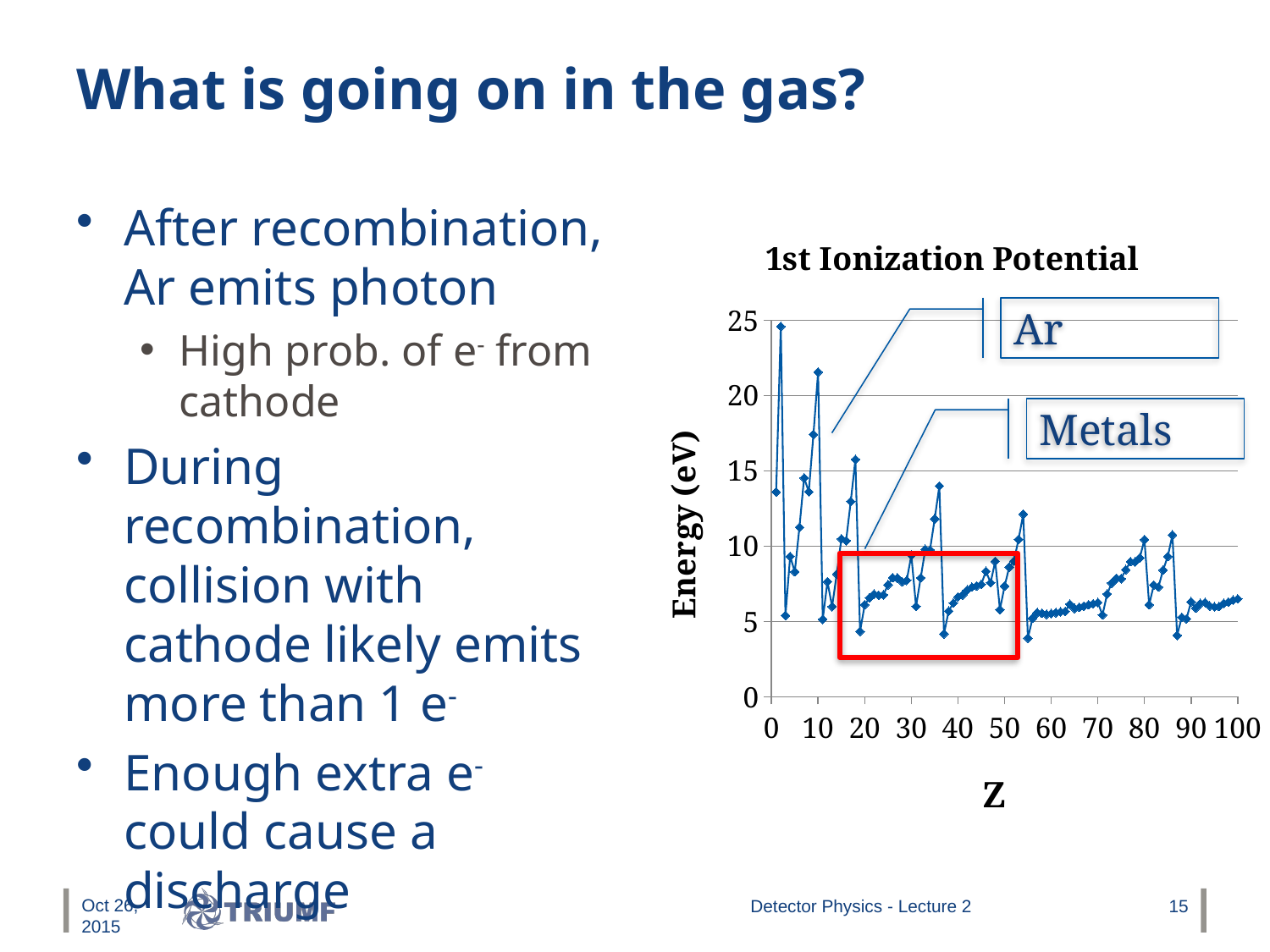
Does the energy rise or fall between Z = 2 and Z = 3? fall Is the value at Z = 55 greater or less than 5? less Is the value at Z = 18 greater or less than 10? greater Is the value at Z = 2 greater or less than 20? greater What kind of chart is shown on the slide? line chart What is the label of the y axis of the chart? Energy (eV) Which is larger, the value at Z = 2 or the value at Z = 10? Z = 2 Is the highest point on the chart located near the left end or the right end of the x axis? left end What is the title of the chart? 1st Ionization Potential